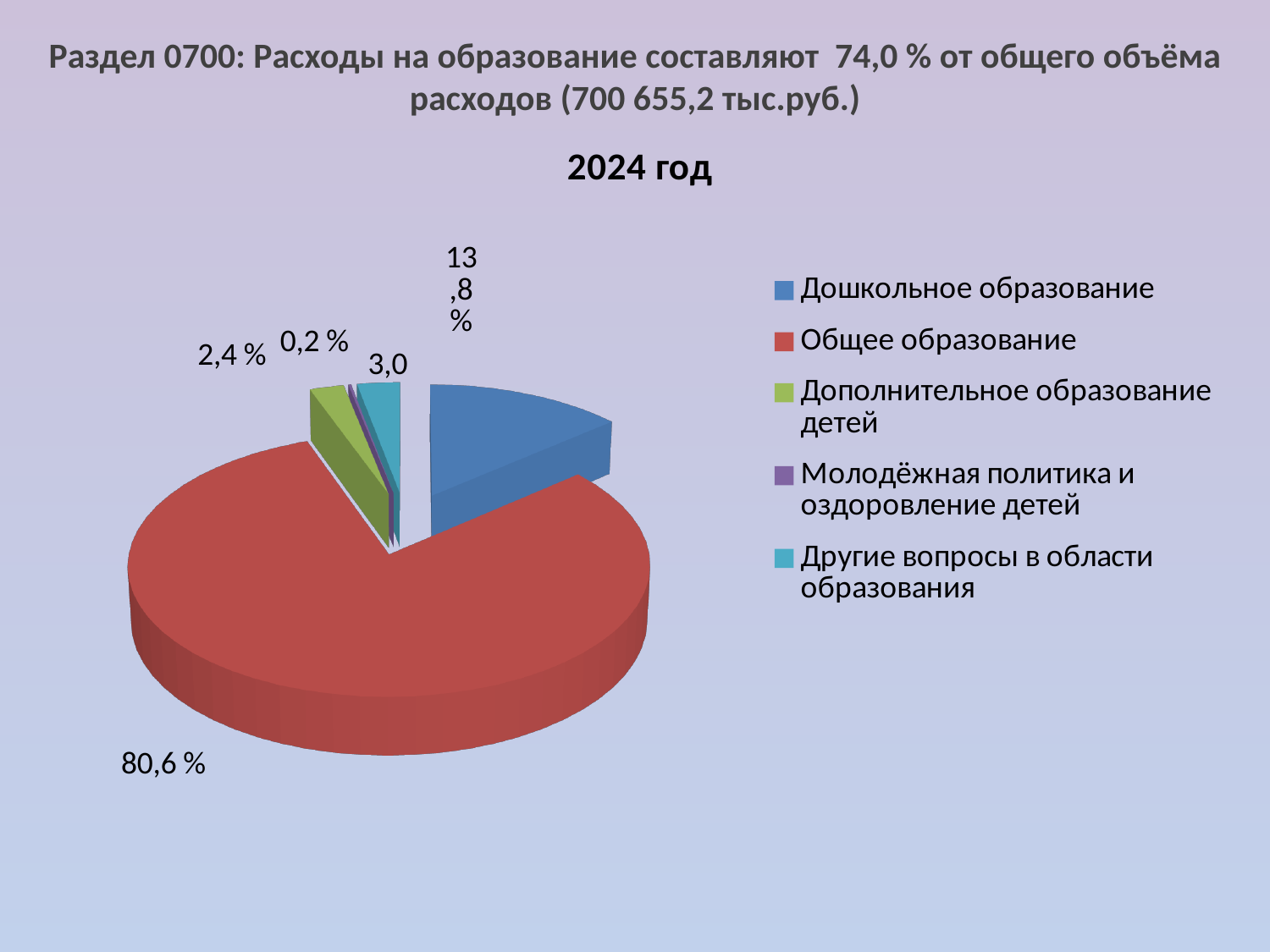
How many slices does the pie chart have? 5 What kind of chart is shown on the slide? pie chart What is the difference between the shares of Общее образование and Дошкольное образование? 66,8 % What is the value shown for Другие вопросы в области образования? 3,0 What is the value shown for Дополнительное образование детей? 2,4 % Which category has the largest slice of the pie? Общее образование What is the value shown for Дошкольное образование? 13,8 % Which is larger: Дошкольное образование or Дополнительное образование детей? Дошкольное образование What is the value shown for Молодёжная политика и оздоровление детей? 0,2 % How many entries does the legend list? 5 Which category has the smallest slice of the pie? Молодёжная политика и оздоровление детей What share of the pie does Общее образование have? 80,6 %